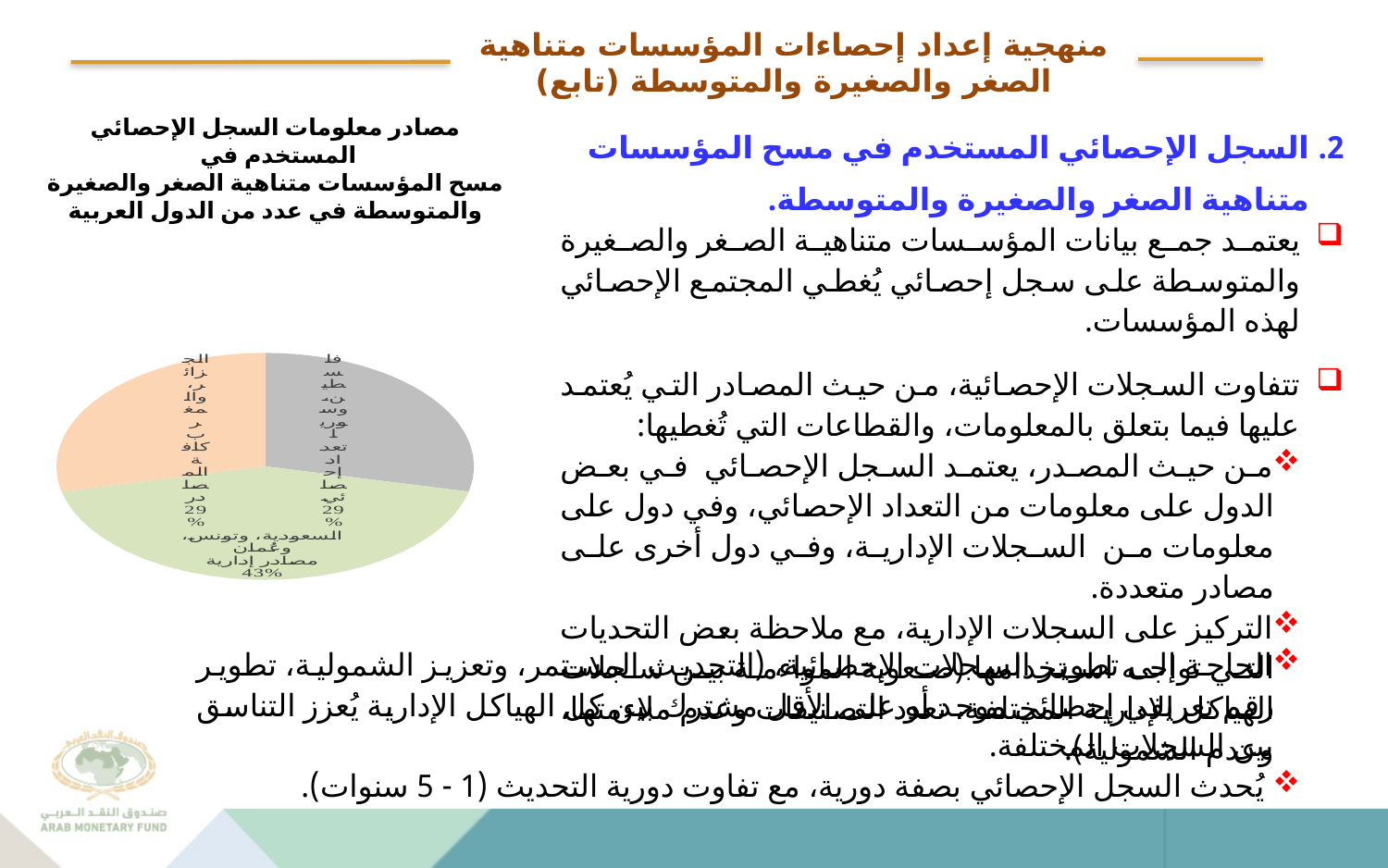
How many slices does the pie chart have? 3 What percentage do each of the two smaller slices of the pie chart show? 29% Is the share of the "مصادر إدارية" slice greater or less than 40%? greater What colour is the largest (43%) slice of the pie chart? Green What kind of chart is shown on the slide? Pie chart What percentage is shown for the slice labelled "السعودية، وتونس، وعُمان مصادر إدارية"? 43% Is the slice for "مصادر إدارية" (43%) larger or smaller than each of the other two slices? Larger Which slice of the pie chart is the largest? السعودية، وتونس، وعُمان مصادر إدارية (43%) What is the title of the pie chart? مصادر معلومات السجل الإحصائي المستخدم في مسح المؤسسات متناهية الصغر والصغيرة والمتوسطة في عدد من الدول العربية What is the value of the largest slice in the pie chart? 43% Are the two smaller slices of the pie chart equal in value? Yes, both are 29% What is the difference in percentage points between the 43% slice and one of the 29% slices? 14